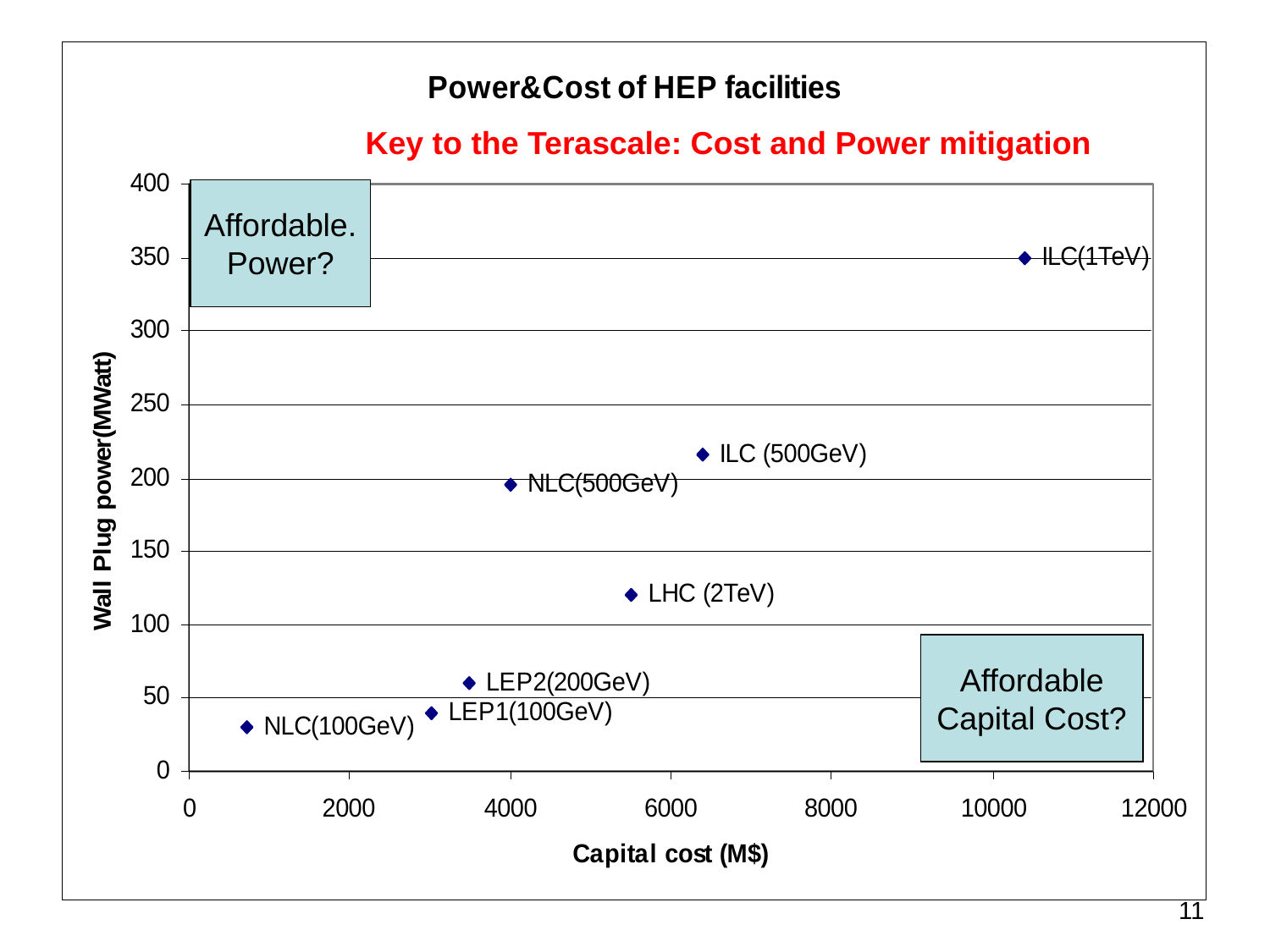
Is the wall plug power for ILC (500GeV) greater or less than 200? greater Is the wall plug power for LHC (2TeV) greater or less than 100? greater Which has the higher capital cost, ILC (500GeV) or LHC (2TeV)? ILC (500GeV) What is the label of the x axis? Capital cost (M$) Which facility has the highest capital cost? ILC(1TeV) Is the capital cost for ILC(1TeV) greater or less than 10000? greater Which facility has the highest wall plug power? ILC(1TeV) Which has the higher wall plug power, ILC (500GeV) or NLC(500GeV)? ILC (500GeV) Which facility has the lowest wall plug power? NLC(100GeV) What kind of chart is shown on the slide? scatter chart How many facilities are plotted as points on the chart? 7